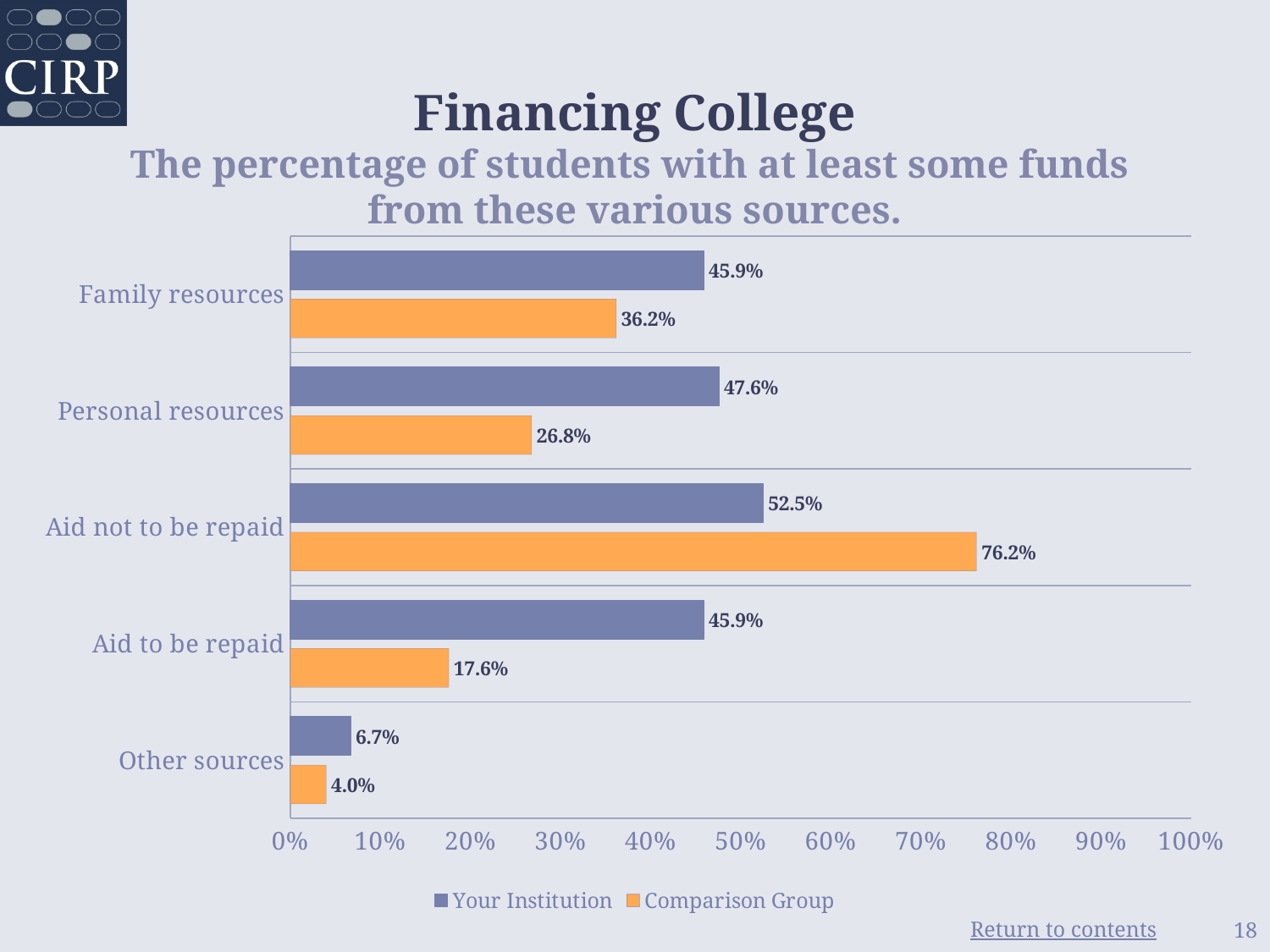
Is the value for Comparison Group for Family resources greater or less than 40%? less How many series does the legend list? 2 What kind of chart is shown on the slide? Bar chart How many categories are shown on the chart? 5 What is the value for Your Institution for Family resources? 45.9% Which category has the lowest value for Comparison Group? Other sources What is the difference between Your Institution and Comparison Group for Aid to be repaid? 28.3% What is the value for Comparison Group for Aid not to be repaid? 76.2% Which is larger for Aid not to be repaid: Your Institution or Comparison Group? Comparison Group What is the value for Your Institution for Other sources? 6.7% What is the value for Comparison Group for Personal resources? 26.8% Which category has the highest value for Your Institution? Aid not to be repaid